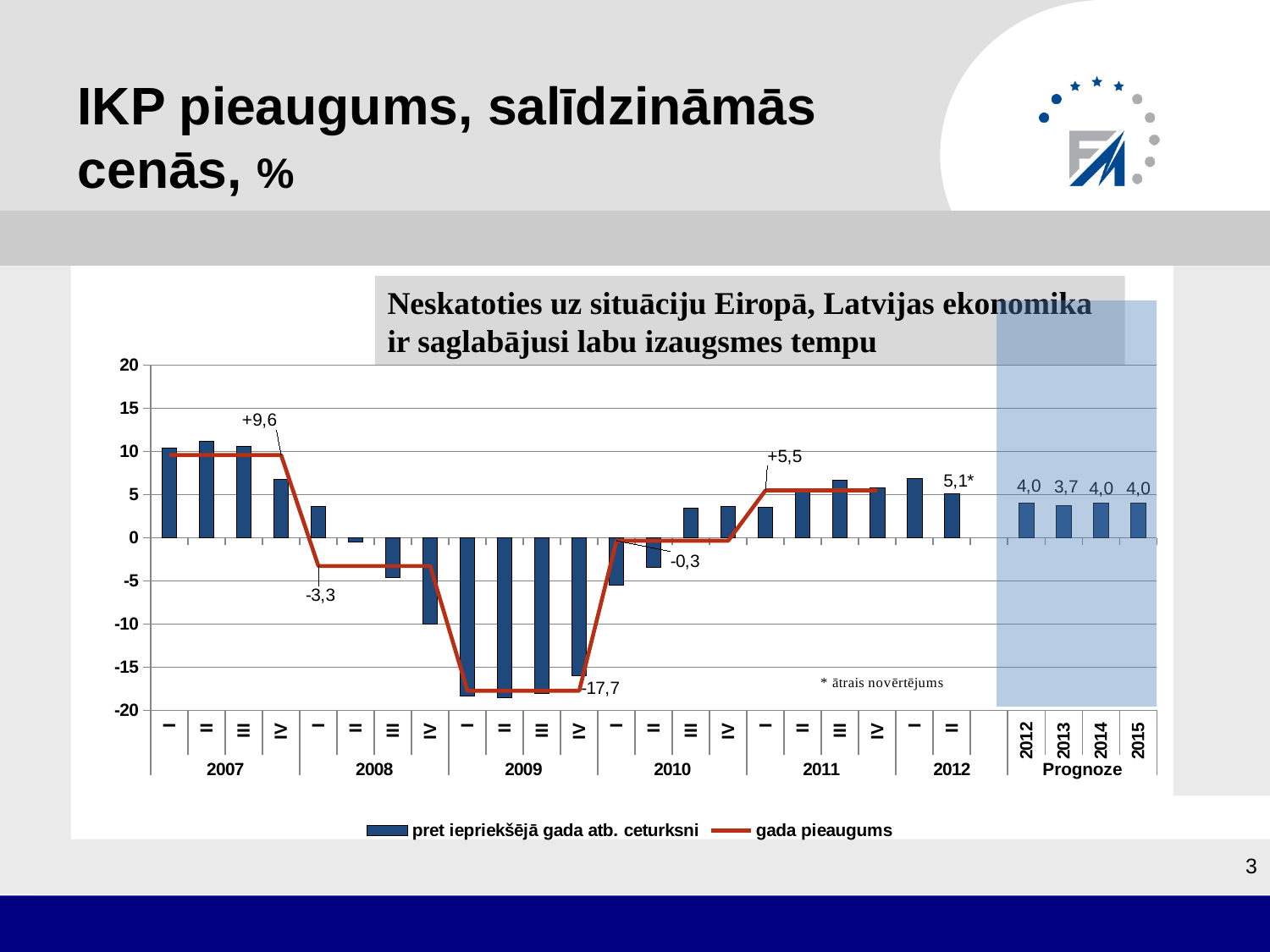
Which year has the lowest annual growth value on the line? 2009 What is the annual growth (gada pieaugums) value shown for 2007? +9,6 Do the quarterly bars rise or fall from quarter I to quarter IV of 2010? rise What is the difference between the annual growth for 2011 (+5,5) and 2010 (-0,3)? 5,8 Which year has the highest annual growth value on the line? 2007 Is the value of the bar for quarter III of 2009 greater or less than -15? less What value is labelled on the bar for quarter II of 2012? 5,1* Which forecast year has the larger value, 2013 or 2014? 2014 How many series does the legend list? 2 What is the annual growth value shown for 2009? -17,7 What kind of chart is shown on the slide? Combined bar and line chart What is the forecast (Prognoze) value for 2013? 3,7